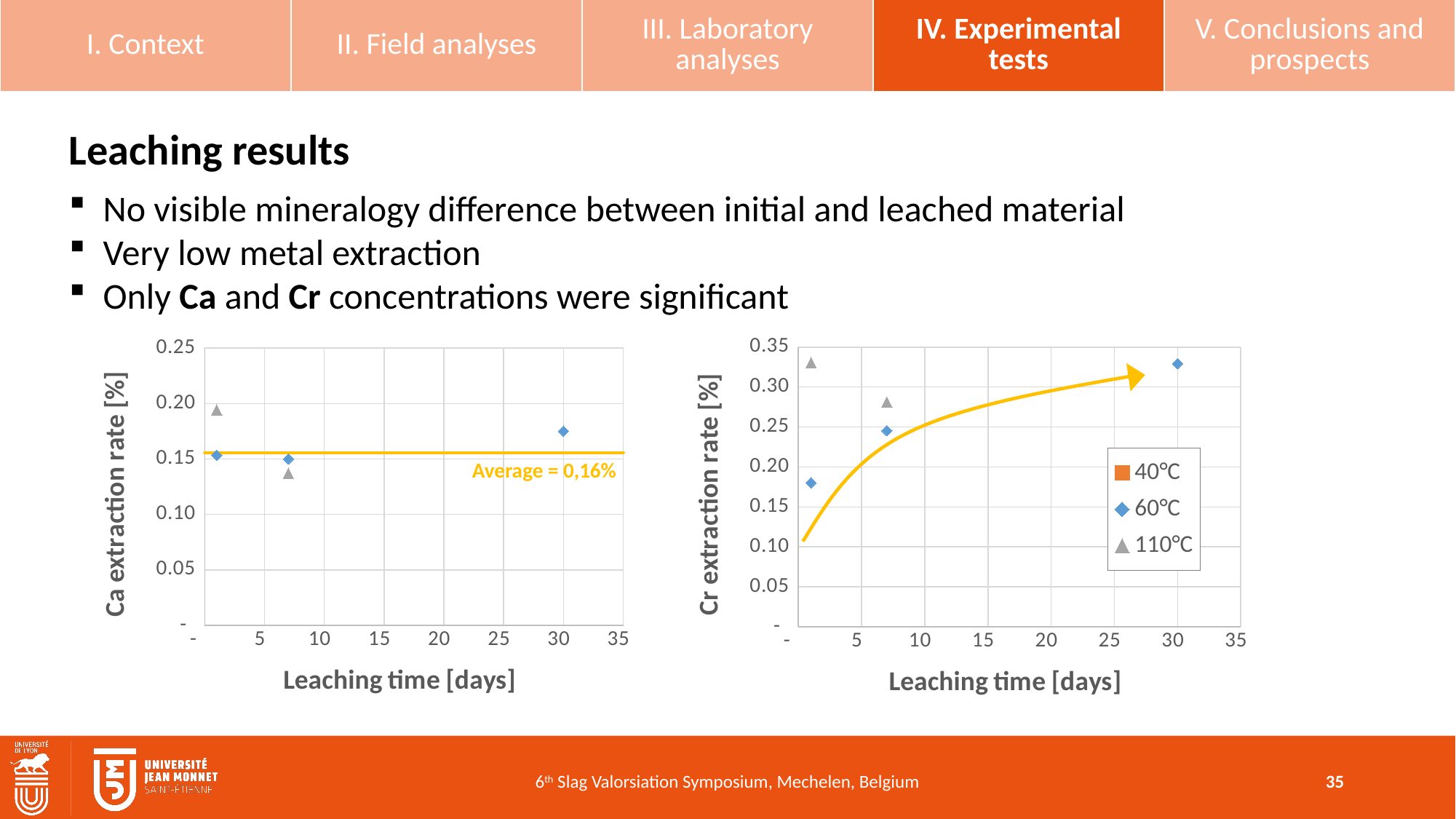
What is the x-axis title of the right chart (Cr extraction rate)? Leaching time [days] How many series does the legend of the right chart (Cr extraction rate) list? 3 In the right chart (Cr extraction rate), do the 60°C values rise or fall as leaching time increases? rise In the right chart (Cr extraction rate), is the 60°C value at 30 days greater or less than 0.30? greater In the right chart (Cr extraction rate), is the 60°C value at about 1 day greater or less than 0.20? less In the left chart (Ca extraction rate), is the 60°C value at 30 days greater or less than 0.15? greater What is the y-axis title of the left chart? Ca extraction rate [%] What type of chart is the left chart showing Ca extraction rate? Scatter chart In the right chart (Cr extraction rate), which is larger at about 7 days: the 60°C value or the 110°C value? 110°C In the left chart (Ca extraction rate), what average value is printed next to the horizontal line? 0,16%